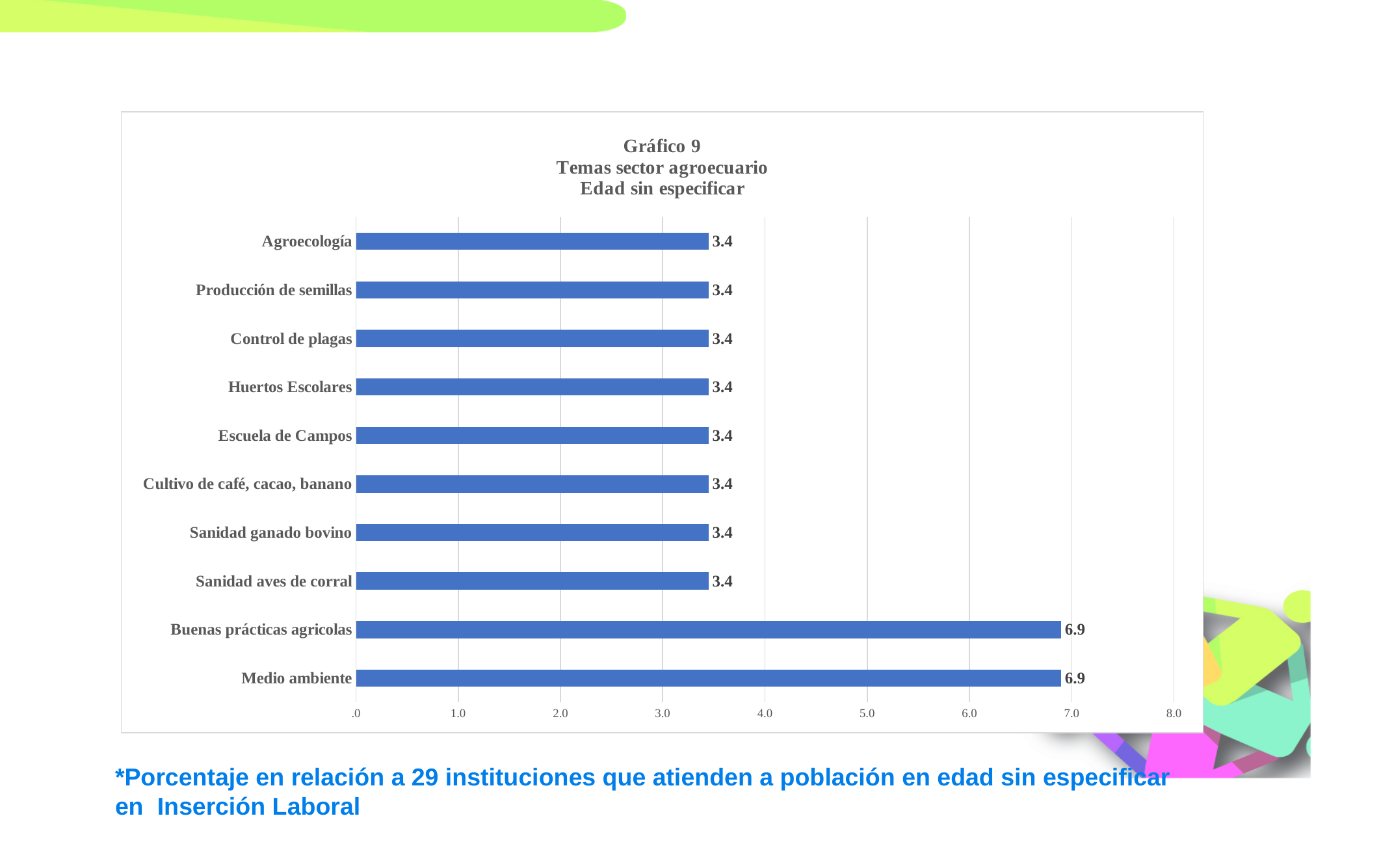
What is the difference between the value for Medio ambiente and the value for Huertos Escolares? 3.5 How many categories are shown in the chart? 10 How many categories have a value of 3.4? 8 Which is larger, the value for Buenas prácticas agricolas or the value for Control de plagas? Buenas prácticas agricolas What kind of chart is shown on the slide? bar chart Is the value for Medio ambiente greater or less than 6.0? greater Is the value for Escuela de Campos greater or less than 4.0? less What is the value for Buenas prácticas agricolas? 6.9 What is the title of the chart? Gráfico 9 Temas sector agroecuario Edad sin especificar What is the value for Medio ambiente? 6.9 What is the value for Sanidad ganado bovino? 3.4 What is the value for Agroecología? 3.4